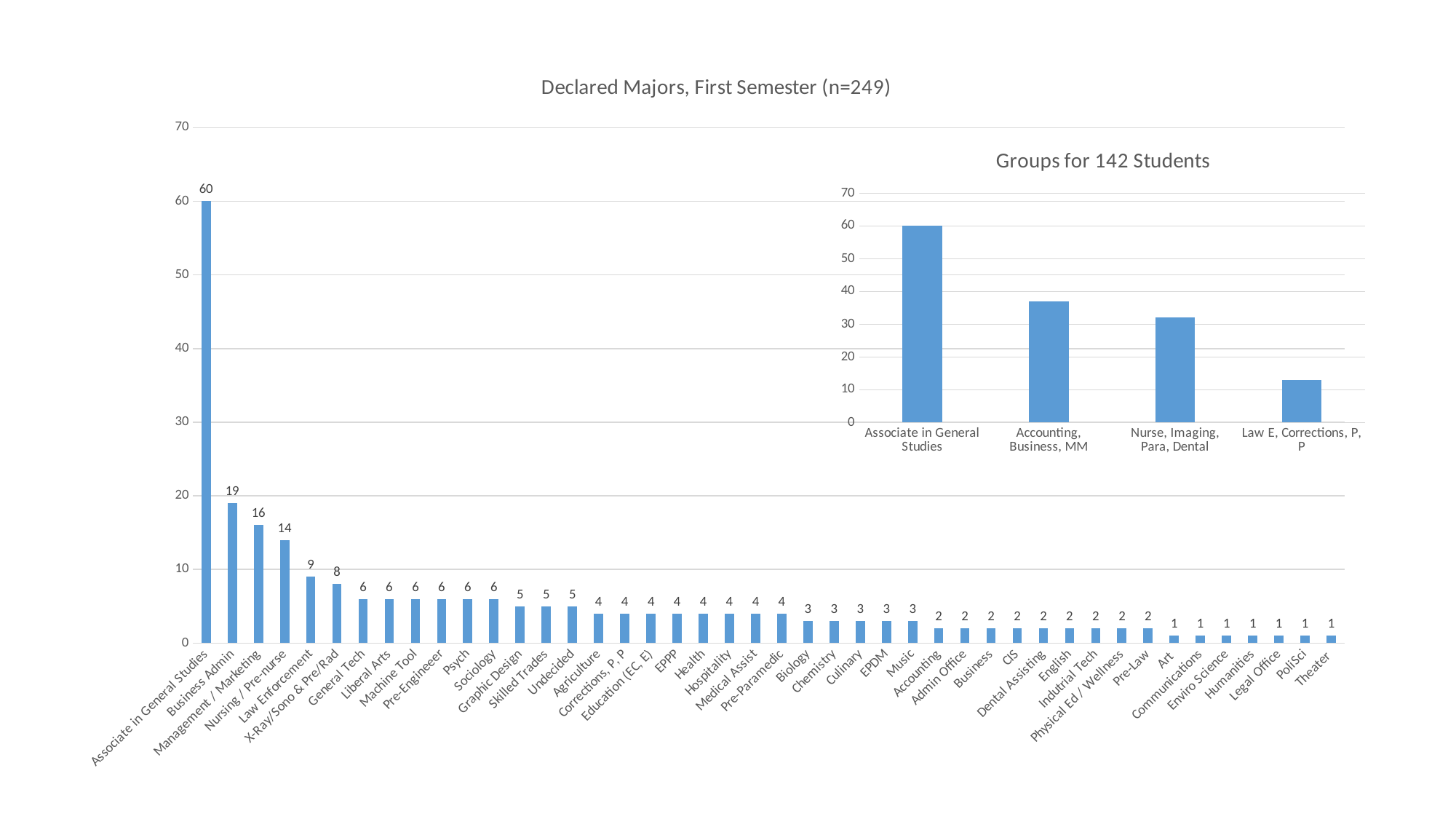
In the 'Declared Majors, First Semester (n=249)' chart, do the values rise or fall from left to right along the x axis? fall In the 'Groups for 142 Students' chart, is the value for 'Accounting, Business, MM' greater or less than 30? greater What kind of chart is 'Groups for 142 Students'? bar chart In the 'Declared Majors, First Semester (n=249)' chart, what is the value for Theater? 1 In the 'Groups for 142 Students' chart, is the value for 'Law E, Corrections, P, P' greater or less than 20? less In the 'Declared Majors, First Semester (n=249)' chart, which category has the highest value? Associate in General Studies In the 'Declared Majors, First Semester (n=249)' chart, what is the value for Graphic Design? 5 In the 'Groups for 142 Students' chart, how many categories are shown? 4 In the 'Declared Majors, First Semester (n=249)' chart, what is the difference between Associate in General Studies and Business Admin? 41 In the 'Declared Majors, First Semester (n=249)' chart, which is larger, Management / Marketing or Nursing / Pre-nurse? Management / Marketing In the 'Declared Majors, First Semester (n=249)' chart, what is the value for Business Admin? 19 In the 'Declared Majors, First Semester (n=249)' chart, what is the value for Law Enforcement? 9